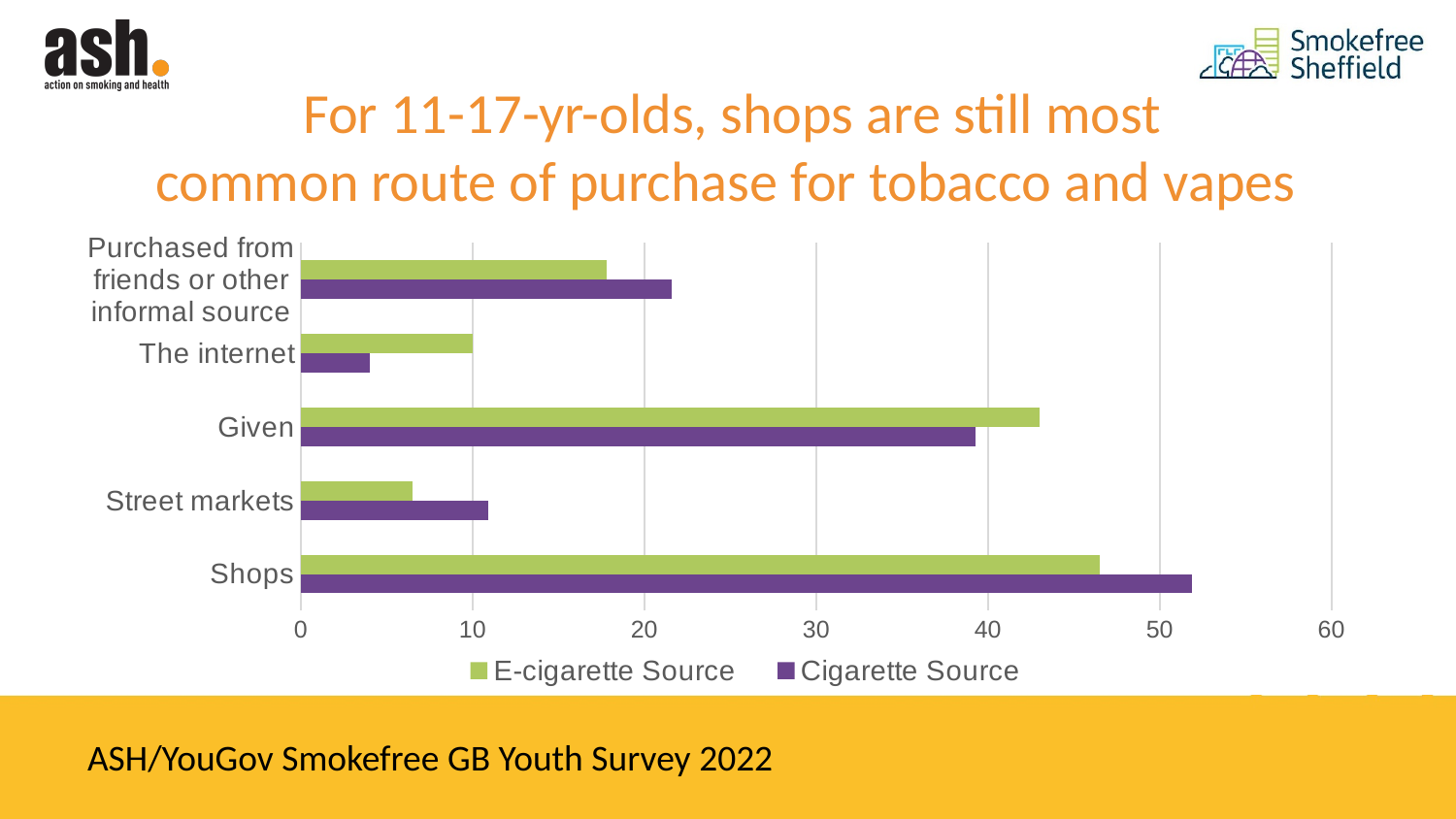
For Street markets, which series has the larger value, E-cigarette Source or Cigarette Source? Cigarette Source Which category has the highest value for the Cigarette Source series? Shops Is the E-cigarette Source value for Given greater or less than 40? greater For The internet, which series has the larger value, E-cigarette Source or Cigarette Source? E-cigarette Source Which series is shown in green in the legend? E-cigarette Source Which category has the lowest value for the Cigarette Source series? The internet Which category has the lowest value for the E-cigarette Source series? Street markets Is the Cigarette Source value for Shops greater or less than 50? greater What kind of chart is shown on the slide? Bar chart How many series does the legend list? 2 Which category has the highest value for the E-cigarette Source series? Shops How many purchase-source categories are shown on the chart? 5